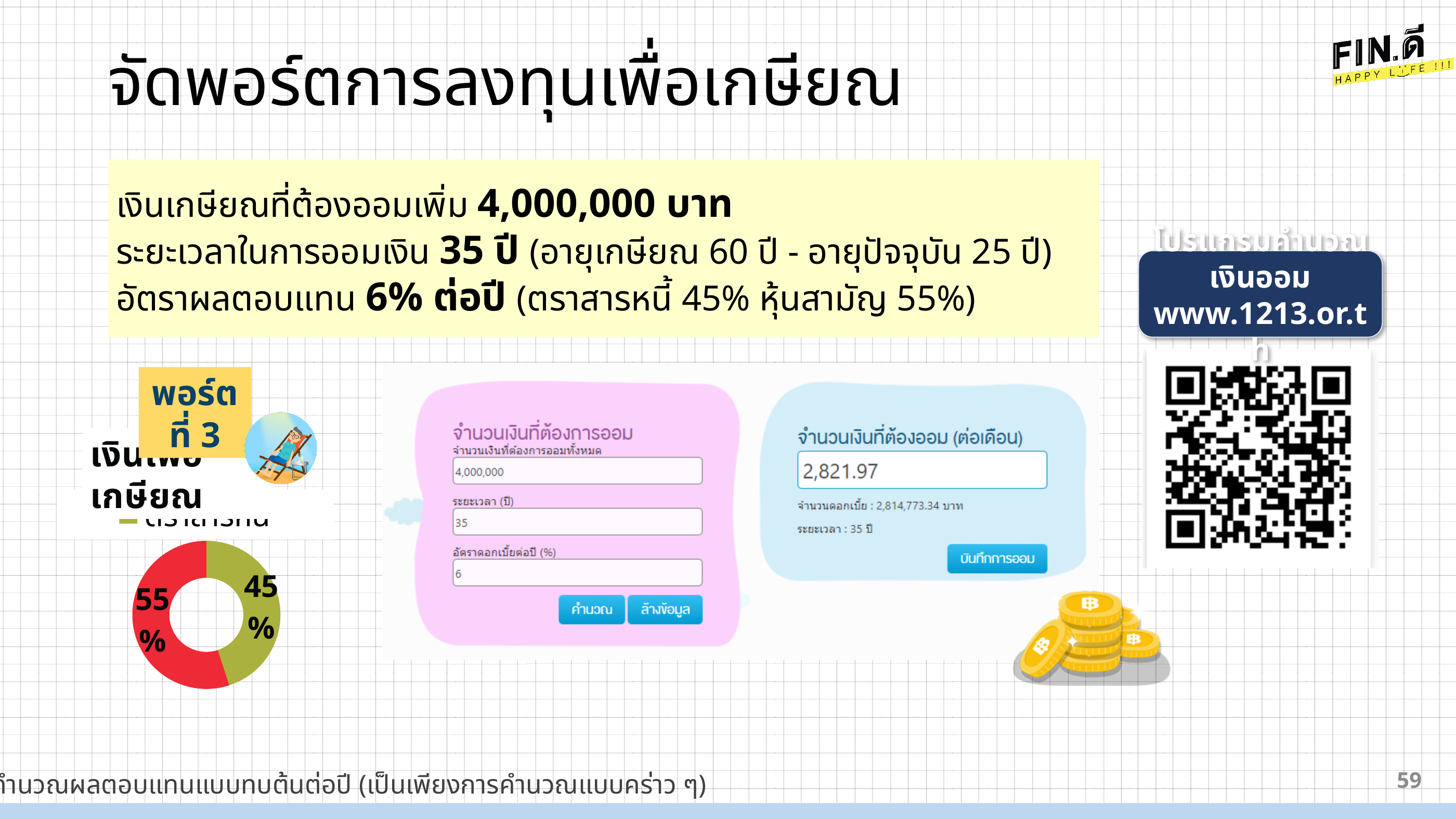
What percentage is shown on the olive-green slice of the donut chart? 45% What percentage is shown on the red slice of the donut chart? 55% What colour is the 45% slice of the donut chart? olive green What kind of chart is shown at the bottom left of the slide? donut (pie) chart Which slice of the donut chart is the smallest? the olive-green slice (45%) What do the two slices of the donut chart add up to? 100% What is the difference between the two slices of the donut chart? 10% How many slices does the donut chart have? 2 What share of the donut chart does the red slice take? 55% Which is larger in the donut chart, the red slice or the olive-green slice? the red slice Is the red slice of the donut chart greater or less than 50%? greater Which slice of the donut chart is the largest? the red slice (55%)